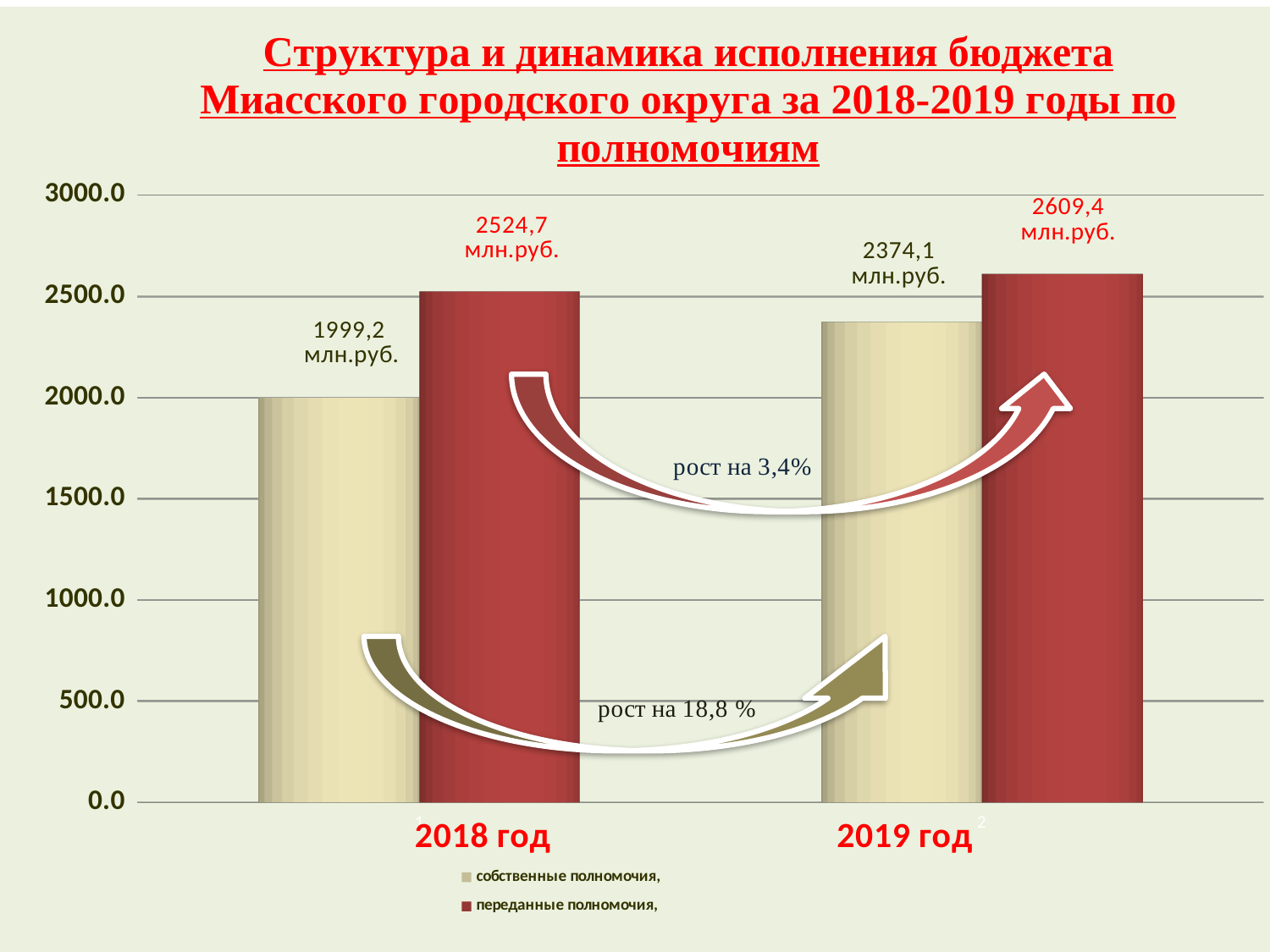
What is the value for собственные полномочия in 2018 год? 1999,2 млн.руб. What is the difference between переданные полномочия and собственные полномочия in 2018 год? 525,5 млн.руб. What kind of chart is shown on the slide? bar chart What is the value for переданные полномочия in 2019 год? 2609,4 млн.руб. What is the value for собственные полномочия in 2019 год? 2374,1 млн.руб. Which bar has the highest value on the chart? переданные полномочия, 2019 год How many series does the legend list? 2 Which bar has the lowest value on the chart? собственные полномочия, 2018 год How many year categories are shown on the x axis? 2 By what percentage did собственные полномочия grow from 2018 to 2019 according to the annotation? 18,8 % What is the value for переданные полномочия in 2018 год? 2524,7 млн.руб. Which is larger in 2019 год: собственные полномочия or переданные полномочия? переданные полномочия